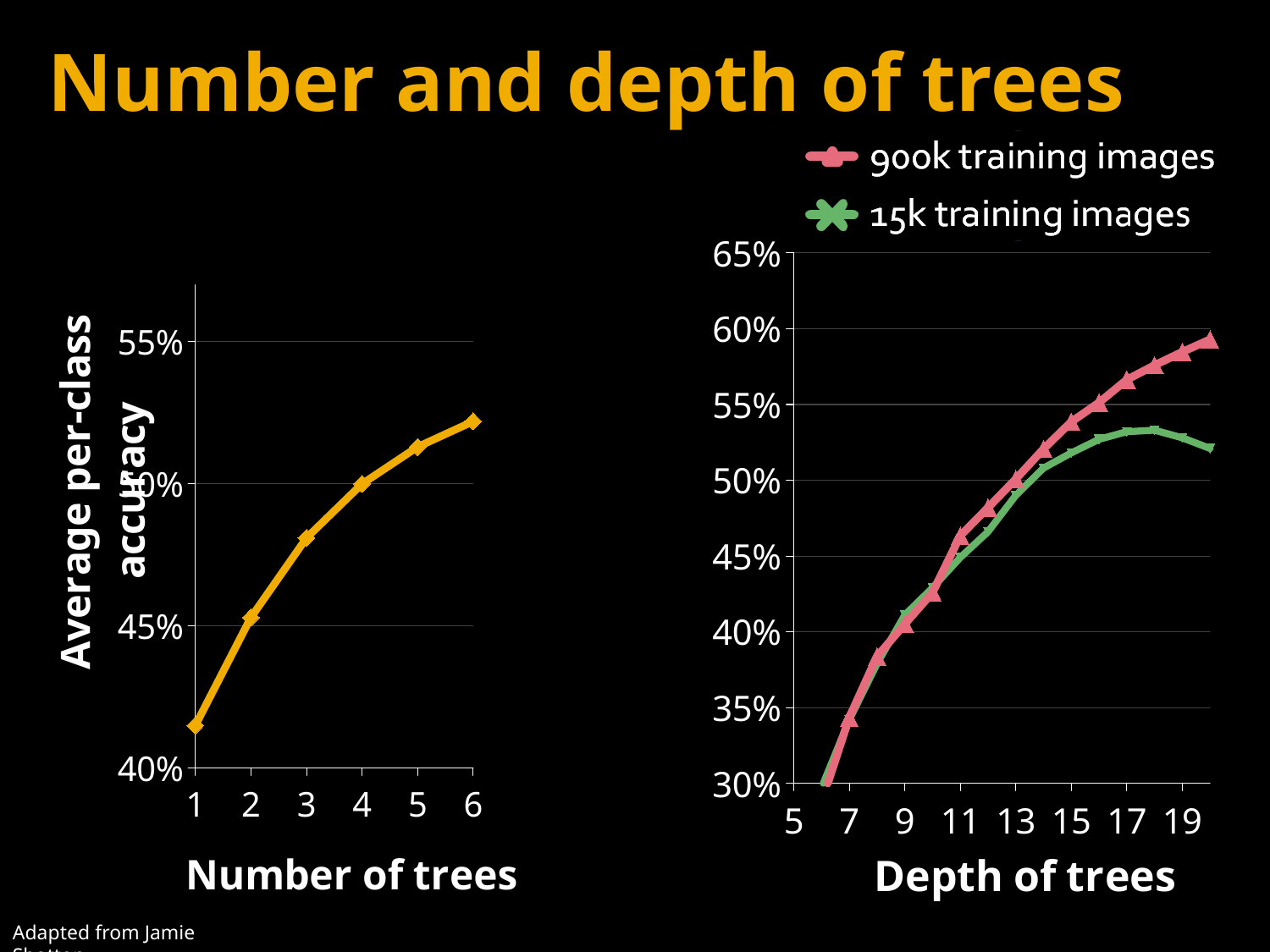
What kind of chart is the left chart, 'Number of trees'? line chart On the right chart, 'Depth of trees', is the value for 900k training images at depth 7 greater or less than 35%? less How many data points are plotted on the left chart, 'Number of trees'? 6 How many series does the legend of the right chart, 'Depth of trees', list? 2 On the left chart, 'Number of trees', does accuracy rise or fall as the number of trees increases? rises On the left chart, 'Number of trees', is the accuracy for 1 tree greater or less than 45%? less On the right chart, 'Depth of trees', what is the label of the x axis? Depth of trees On the left chart, 'Number of trees', is the accuracy for 3 trees greater or less than 50%? less On the right chart, 'Depth of trees', which series has the higher value at depth 19? 900k training images